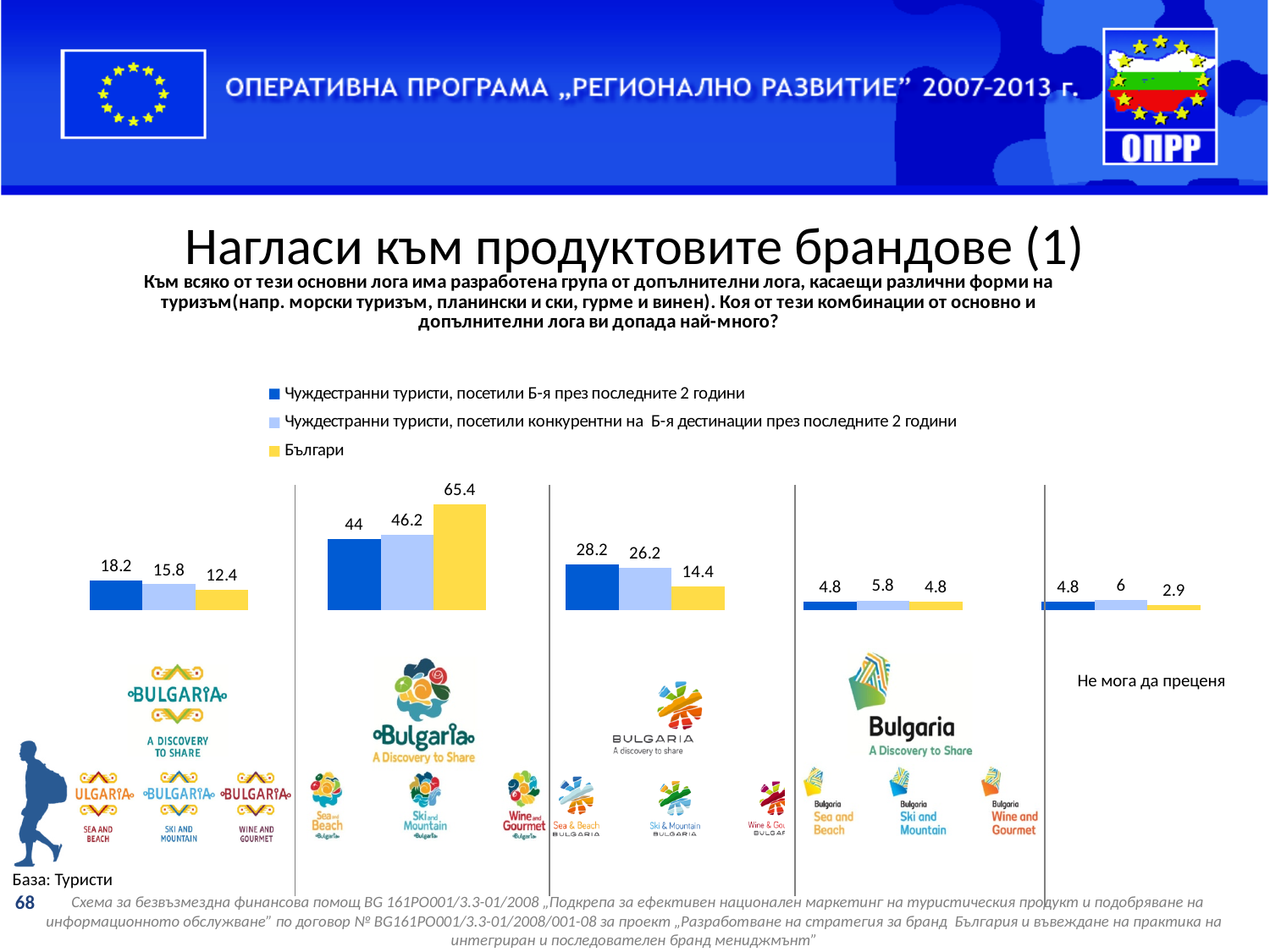
What is the value for 'Чуждестранни туристи, посетили Б-я през последните 2 години' in the 'Не мога да преценя' group? 4.8 What is the lowest value shown in the chart? 2.9 What is the value for 'Чуждестранни туристи, посетили конкурентни на Б-я дестинации през последните 2 години' in the first group of bars from the left? 15.8 What is the value for 'Българи' in the second group of bars from the left? 65.4 Which colour represents the 'Българи' series in the chart? yellow In the third group of bars from the left, which is larger: the value for 'Чуждестранни туристи, посетили Б-я през последните 2 години' or the value for 'Българи'? Чуждестранни туристи, посетили Б-я през последните 2 години What is the highest value shown in the chart? 65.4 How many series does the chart legend list? 3 What is the value for 'Българи' in the 'Не мога да преценя' group? 2.9 What kind of chart is shown on the slide? bar chart How many groups of bars (logo options) are plotted in the chart? 5 In the second group of bars from the left, what is the difference between the 'Българи' value and the 'Чуждестранни туристи, посетили Б-я през последните 2 години' value? 21.4